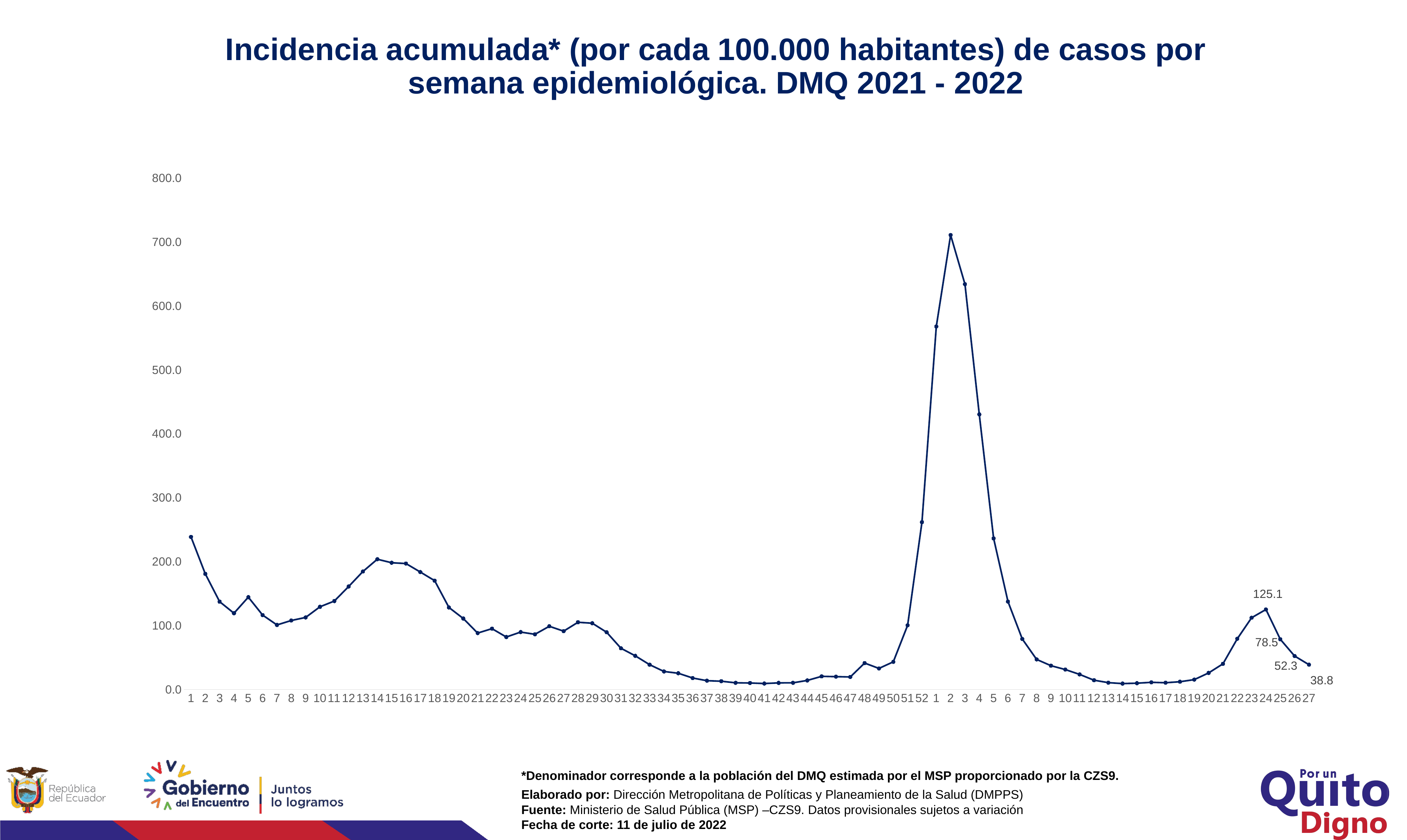
What is the difference between the values for week 26 and week 27 of 2022? 13.5 What is the value for the last point on the chart, week 27 of 2022? 38.8 Which week has the highest value on the chart? week 2 of 2022 What is the value for week 25 of 2022? 78.5 What is the difference between the values for week 24 and week 25 of 2022? 46.6 What is the value for week 26 of 2022? 52.3 Is the value for week 40 of 2021 greater or less than 100? less Is the value for week 2 of 2022 greater or less than 600? greater What is the value for week 24 of 2022? 125.1 Do the values rise or fall from week 24 to week 27 of 2022? fall What kind of chart is shown on the slide? line chart Which is larger, the value for week 1 of 2021 or the value for week 27 of 2022? week 1 of 2021